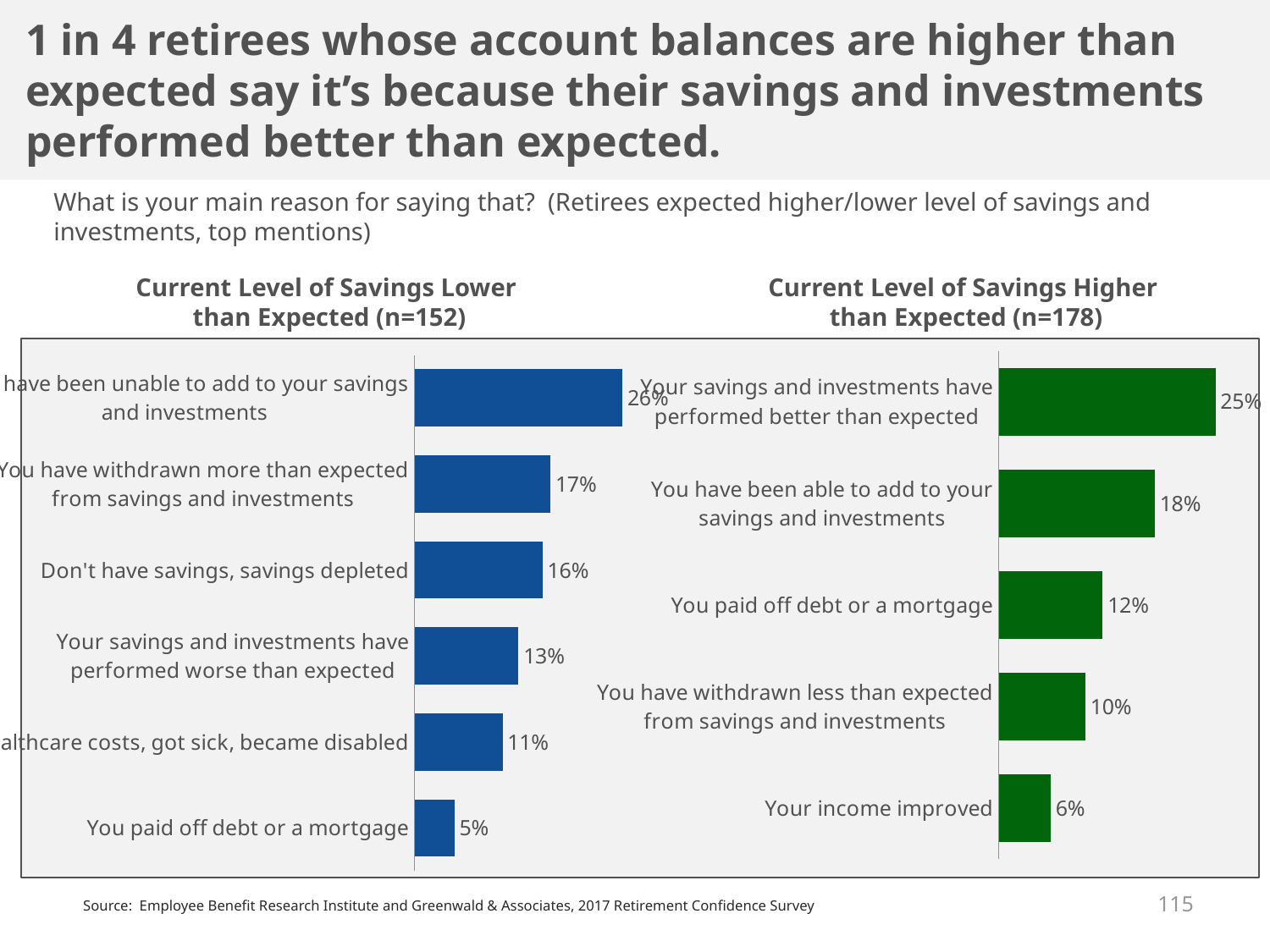
How many reasons are plotted in the 'Current Level of Savings Higher than Expected' chart? 5 In the 'Current Level of Savings Higher than Expected' chart, what percentage is shown for 'Your savings and investments have performed better than expected'? 25% In the 'Current Level of Savings Lower than Expected' chart, what is the difference between 'You have withdrawn more than expected from savings and investments' and 'Your savings and investments have performed worse than expected'? 4 percentage points In the 'Current Level of Savings Higher than Expected' chart, which reason has the lowest percentage? Your income improved What type of chart is used on this slide? Bar chart In the 'Current Level of Savings Lower than Expected' chart, what percentage is shown for 'You paid off debt or a mortgage'? 5% In the 'Current Level of Savings Lower than Expected' chart, which reason has the lowest percentage? You paid off debt or a mortgage Which is larger: 'You paid off debt or a mortgage' in the 'Savings Lower than Expected' chart or 'You paid off debt or a mortgage' in the 'Savings Higher than Expected' chart? Savings Higher than Expected (12%) In the 'Current Level of Savings Lower than Expected' chart, what percentage is shown for 'Don't have savings, savings depleted'? 16% How many reasons are plotted in the 'Current Level of Savings Lower than Expected' chart? 6 In the 'Current Level of Savings Higher than Expected' chart, what percentage is shown for 'Your income improved'? 6% In the 'Current Level of Savings Higher than Expected' chart, what is the difference between 'You have been able to add to your savings and investments' and 'You paid off debt or a mortgage'? 6 percentage points